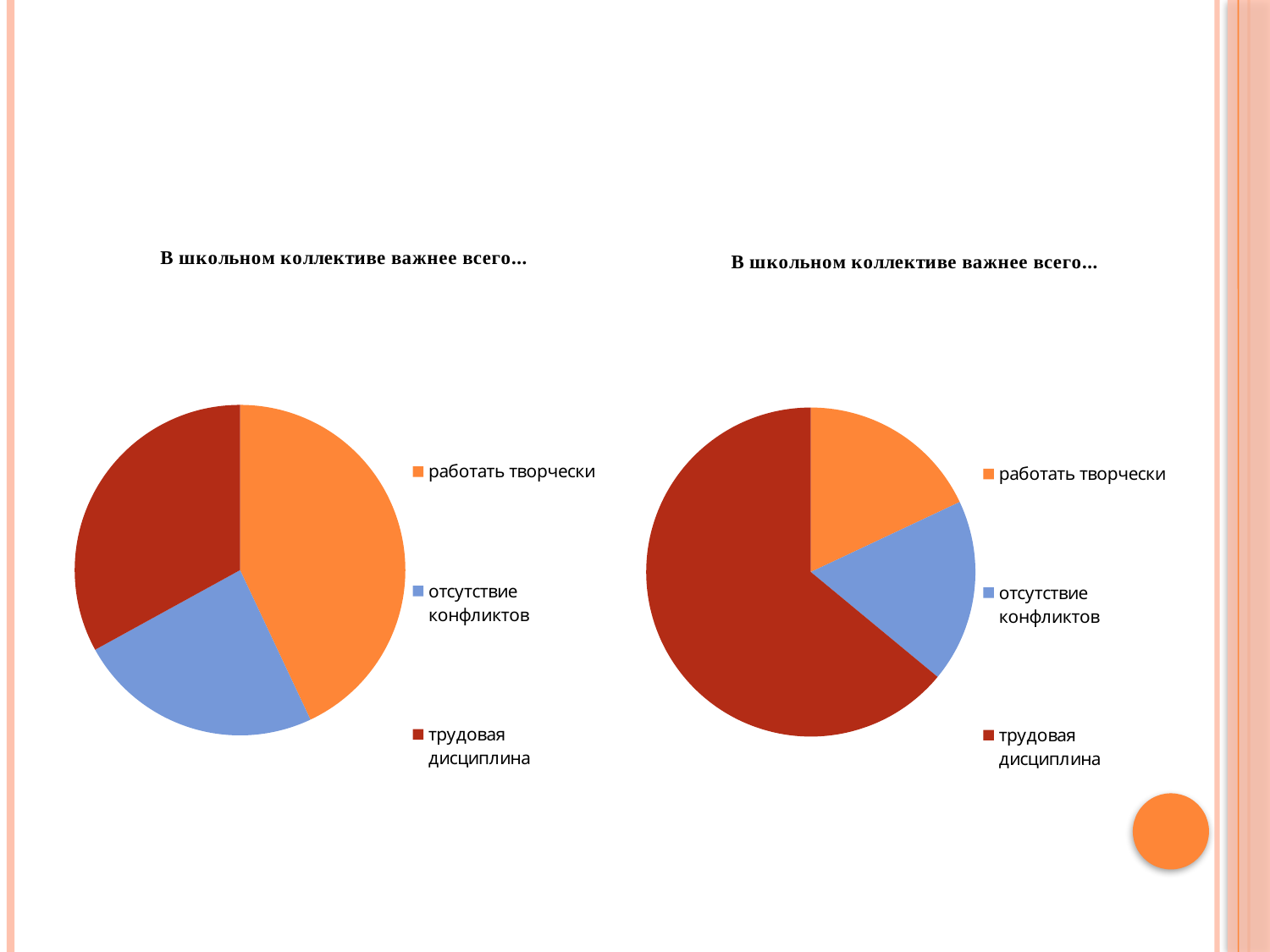
In the right pie chart, which category has the largest slice? трудовая дисциплина In the right chart, what colour is the slice for отсутствие конфликтов? blue In the right pie chart, which slice is larger: трудовая дисциплина or работать творчески? трудовая дисциплина How many slices does the right pie chart have? 3 In the left pie chart, which slice is larger: работать творчески or отсутствие конфликтов? работать творчески In the right pie chart, which slice is larger: отсутствие конфликтов or трудовая дисциплина? трудовая дисциплина What kind of chart is the left chart on the slide? pie chart How many slices does the left pie chart have? 3 How many entries does the legend of the right chart list? 3 What is the title of the left chart? В школьном коллективе важнее всего... In the left pie chart, which category has the smallest slice? отсутствие конфликтов What kind of chart is the right chart on the slide? pie chart